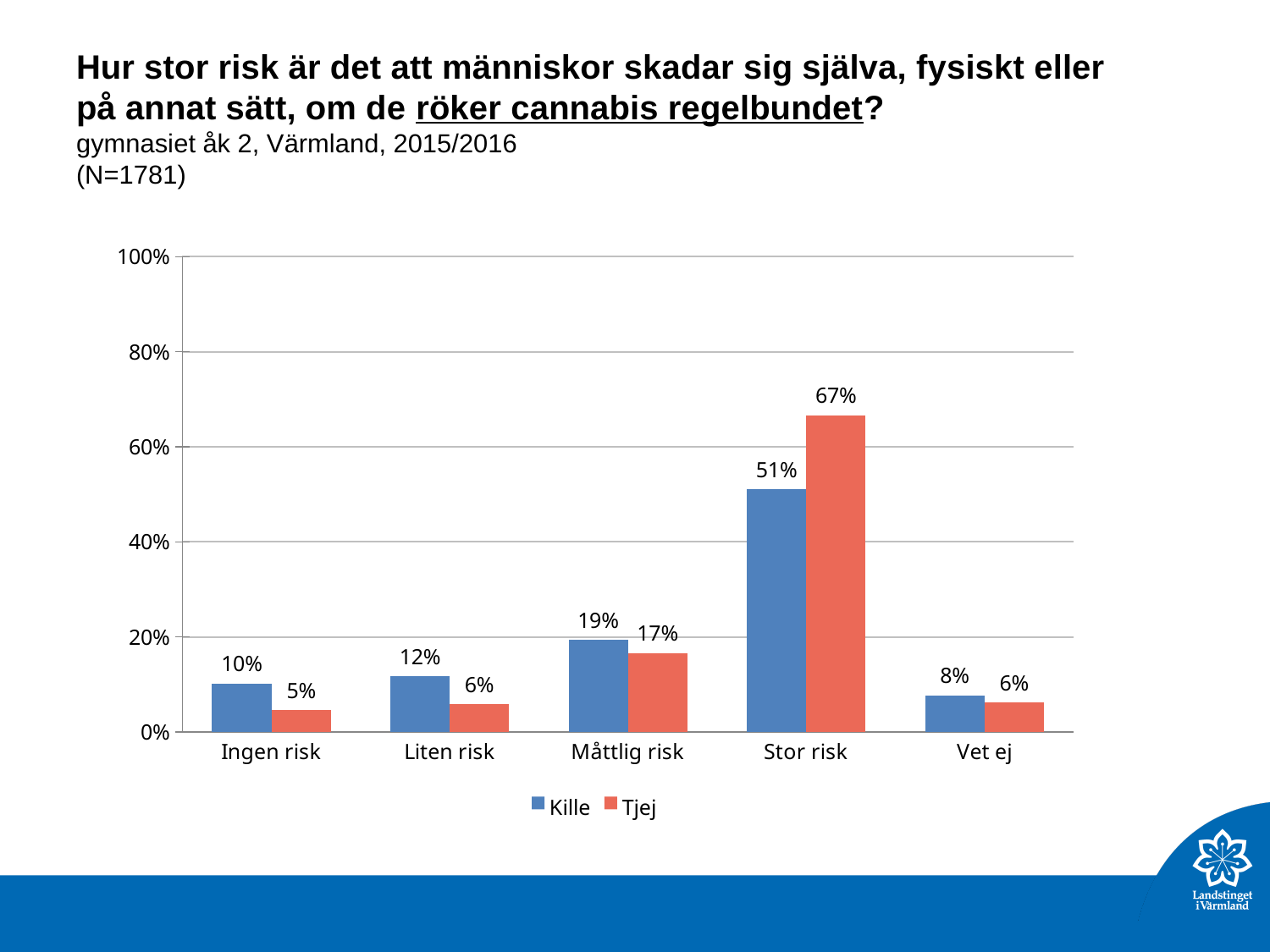
What is the difference between the Tjej and Kille values in the Stor risk category? 16% What is the value for Kille in the Stor risk category? 51% Which category has the highest value for Tjej? Stor risk Which category has the lowest value for Kille? Vet ej What is the value for Tjej in the Måttlig risk category? 17% What kind of chart is shown on the slide? bar chart What are the two series named in the legend? Kille and Tjej How many series does the legend list? 2 Which is larger in the Liten risk category, Kille or Tjej? Kille What is the value for Tjej in the Ingen risk category? 5% Is the value for Tjej in the Stor risk category greater or less than 60%? greater How many categories are shown on the x axis? 5